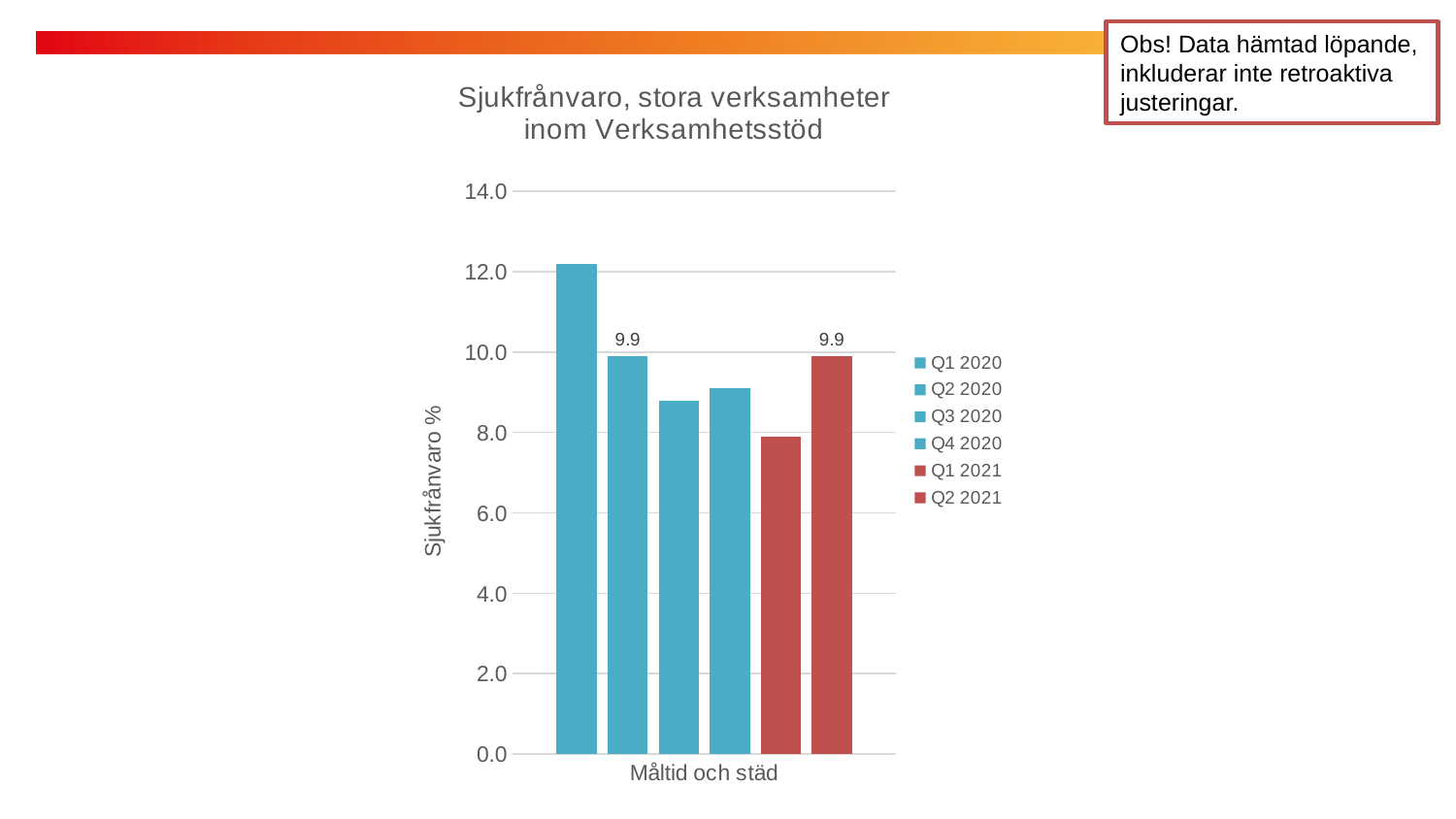
What kind of chart is shown on the slide? Bar chart Which is larger, the value for Q1 2020 or the value for Q3 2020? Q1 2020 Is the value for Q3 2020 greater or less than 10.0? less What is the difference between the values for Q2 2020 and Q2 2021? 0 Is the value for Q1 2020 greater or less than 10.0? greater What is the label on the y axis of the chart? Sjukfrånvaro % What is the value for Q2 2021 in the chart? 9.9 What is the value for Q2 2020 in the chart? 9.9 Which quarter has the highest sick leave value in the chart? Q1 2020 Is the value for Q1 2021 greater or less than 10.0? less How many series does the legend list? 6 Which quarter has the lowest sick leave value in the chart? Q1 2021